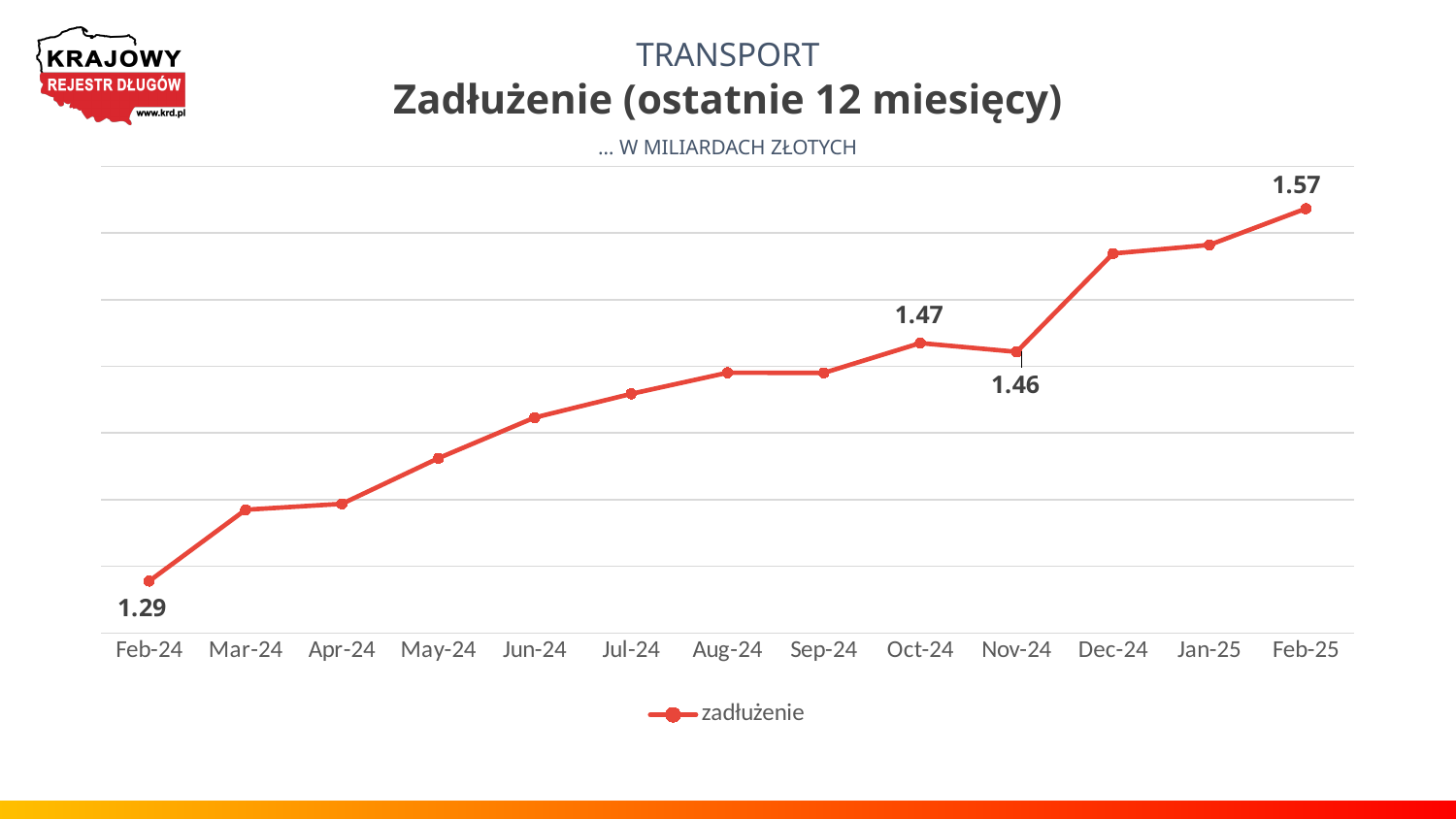
What kind of chart is shown? line chart Which month has the highest value? Feb-25 Do the values generally rise or fall from Feb-24 to Feb-25? rise What is the value for Feb-24? 1.29 Which month has the lowest value? Feb-24 What is the value for Nov-24? 1.46 How many series does the legend list? 1 What is the difference between the values for Feb-25 and Feb-24? 0.28 Which is larger, the value for Oct-24 or the value for Nov-24? Oct-24 How many months are plotted on the x axis? 13 What is the value for Oct-24? 1.47 What is the value for Feb-25? 1.57